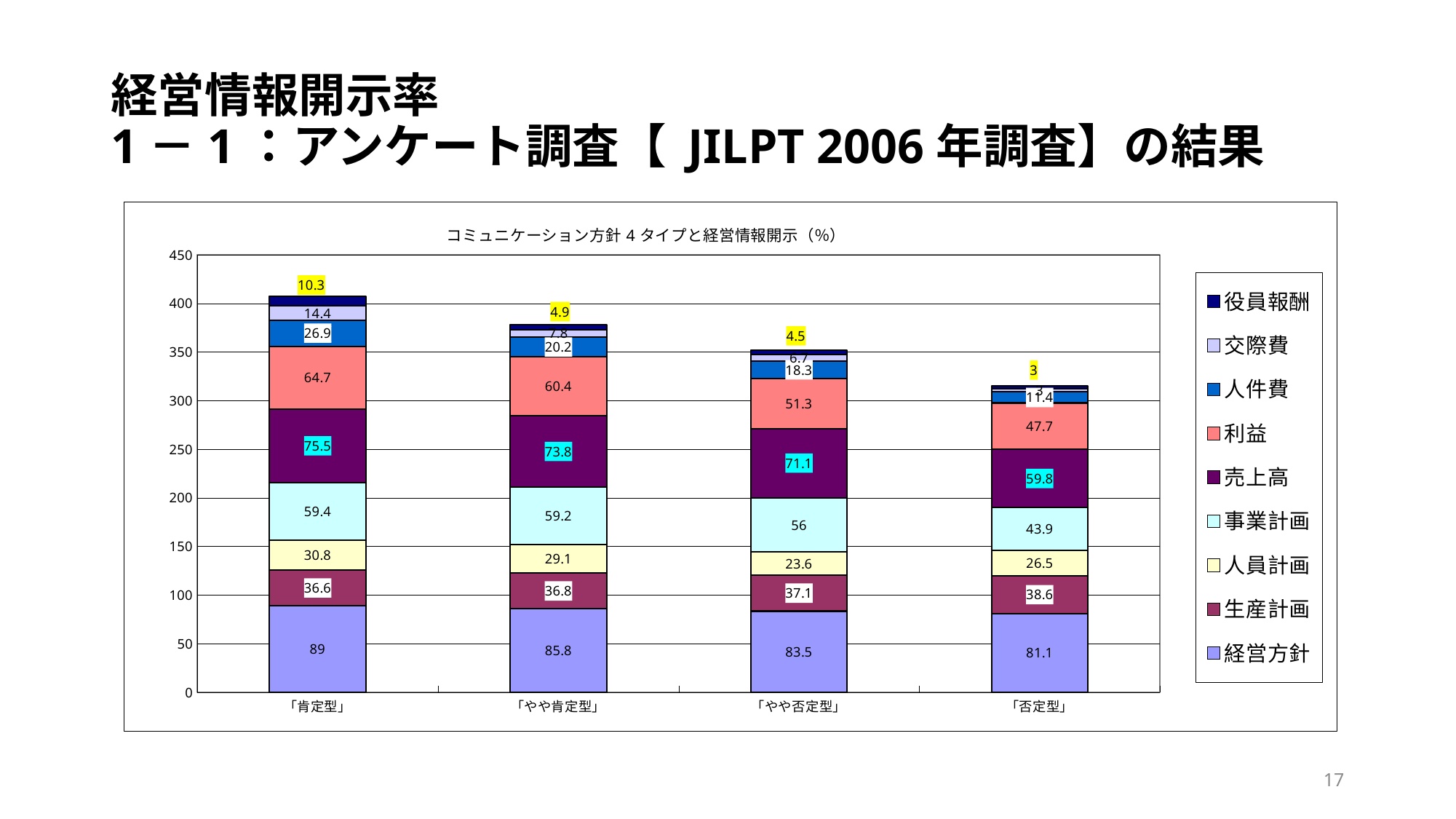
What is the value of 利益 for 「やや否定型」? 51.3 Which category has the highest value for 経営方針? 「肯定型」 What is the value of 経営方針 for 「肯定型」? 89 How many series does the legend list? 9 Which category has the lowest value for 人件費? 「否定型」 What is the value of 売上高 for 「否定型」? 59.8 Does the 経営方針 value rise or fall from 「肯定型」 to 「否定型」 along the x axis? fall Is the total height of the 「否定型」 stacked bar greater or less than 350? less What is the value of 役員報酬 for 「やや肯定型」? 4.9 What is the difference between the 利益 values for 「肯定型」 and 「否定型」? 17 How many categories are shown on the x axis? 4 Which has the larger 事業計画 value, 「やや肯定型」 or 「やや否定型」? 「やや肯定型」